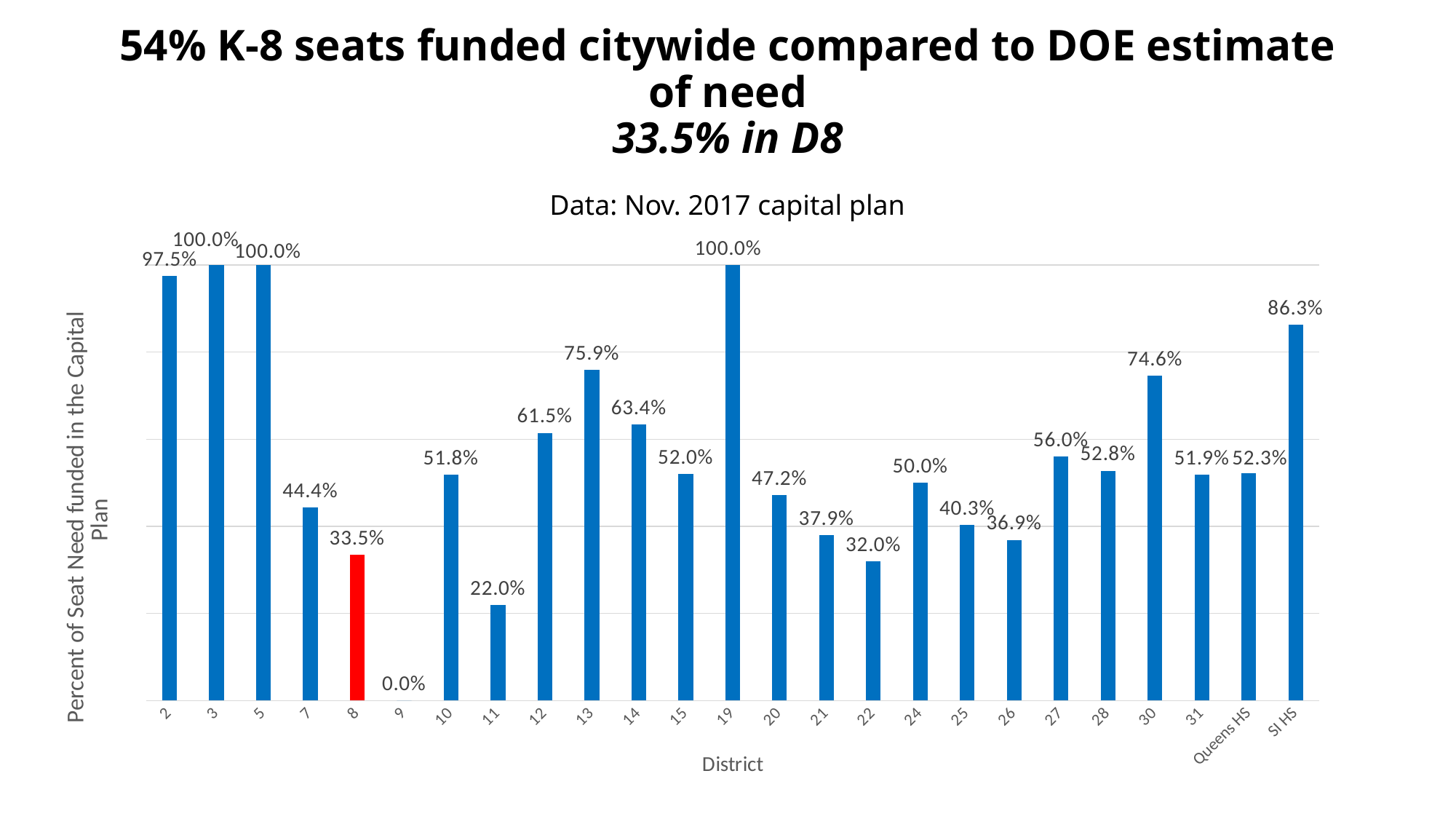
What is the difference between the values for District 30 and District 8? 41.1% What is the value for District 8? 33.5% Which district has the lowest value? 9 Which district's bar is coloured red? 8 What is the value for SI HS? 86.3% How many districts are shown on the x axis? 25 Which is larger, the value for District 12 or the value for District 14? District 14 Which is larger, the value for District 22 or the value for District 25? District 25 What is the value for District 13? 75.9% What kind of chart is shown on the slide? Bar chart What is the value for District 11? 22.0% What is the difference between the values for District 2 and District 7? 53.1%